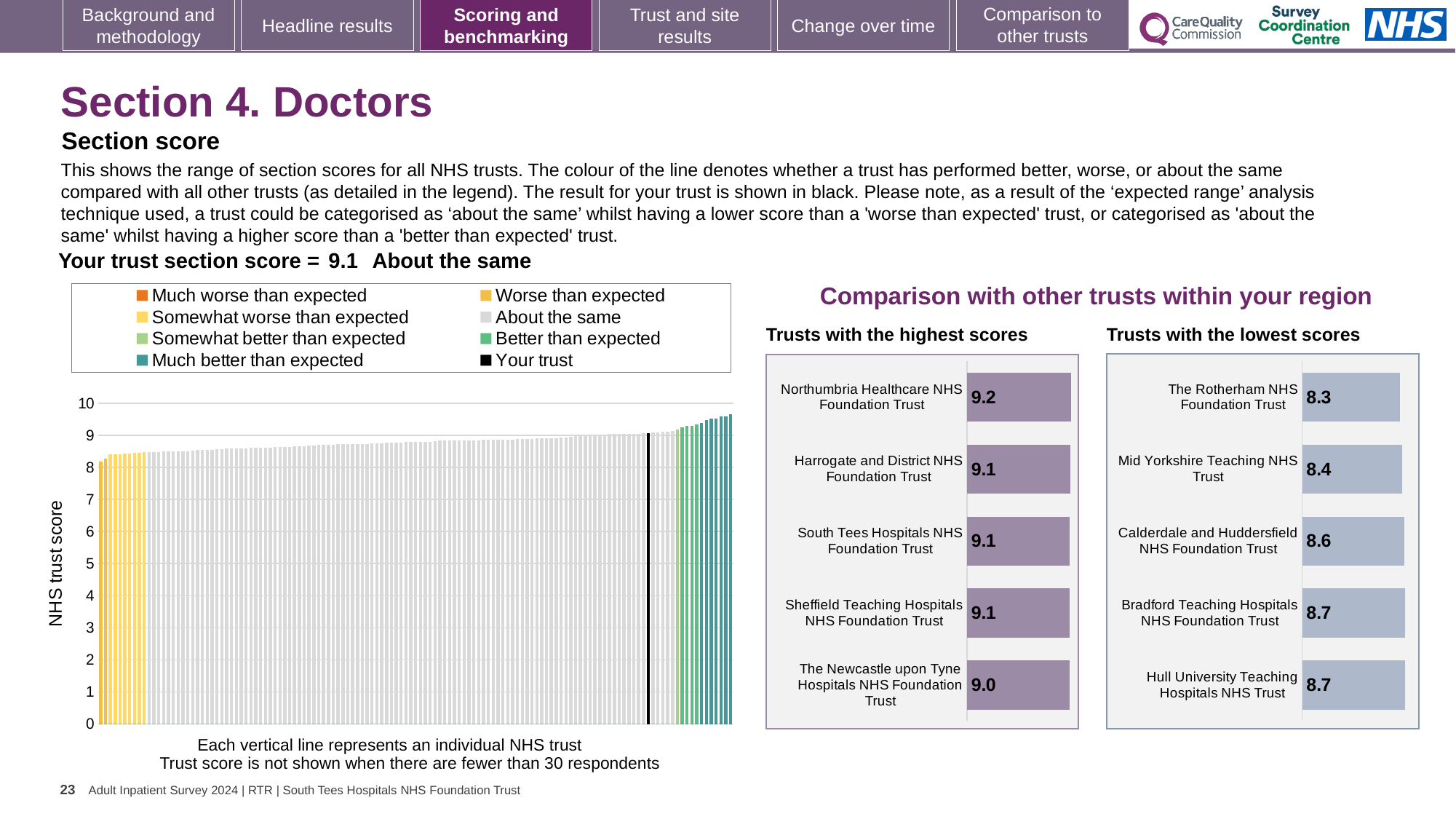
In the 'Trusts with the lowest scores' chart, which trust has the lowest score? The Rotherham NHS Foundation Trust In the NHS trust score chart on the left, do the trust scores rise or fall from left to right along the x axis? Rise In the 'Trusts with the highest scores' chart, what is the score for Northumbria Healthcare NHS Foundation Trust? 9.2 In the 'Trusts with the highest scores' chart, what is the difference between the scores of Northumbria Healthcare NHS Foundation Trust and The Newcastle upon Tyne Hospitals NHS Foundation Trust? 0.2 In the 'Trusts with the highest scores' chart, which trust has the lowest score? The Newcastle upon Tyne Hospitals NHS Foundation Trust In the 'Trusts with the highest scores' chart, how many trusts are shown? 5 In the NHS trust score chart on the left, how many entries does the legend list? 8 In the 'Trusts with the lowest scores' chart, what is the difference between the scores of Hull University Teaching Hospitals NHS Trust and The Rotherham NHS Foundation Trust? 0.4 What kind of chart is the NHS trust score chart on the left? Bar chart In the 'Trusts with the lowest scores' chart, what is the score for Calderdale and Huddersfield NHS Foundation Trust? 8.6 In the NHS trust score chart on the left, what is the section score for your trust? 9.1 In the 'Trusts with the lowest scores' chart, which is larger: the score for Mid Yorkshire Teaching NHS Trust or Bradford Teaching Hospitals NHS Foundation Trust? Bradford Teaching Hospitals NHS Foundation Trust